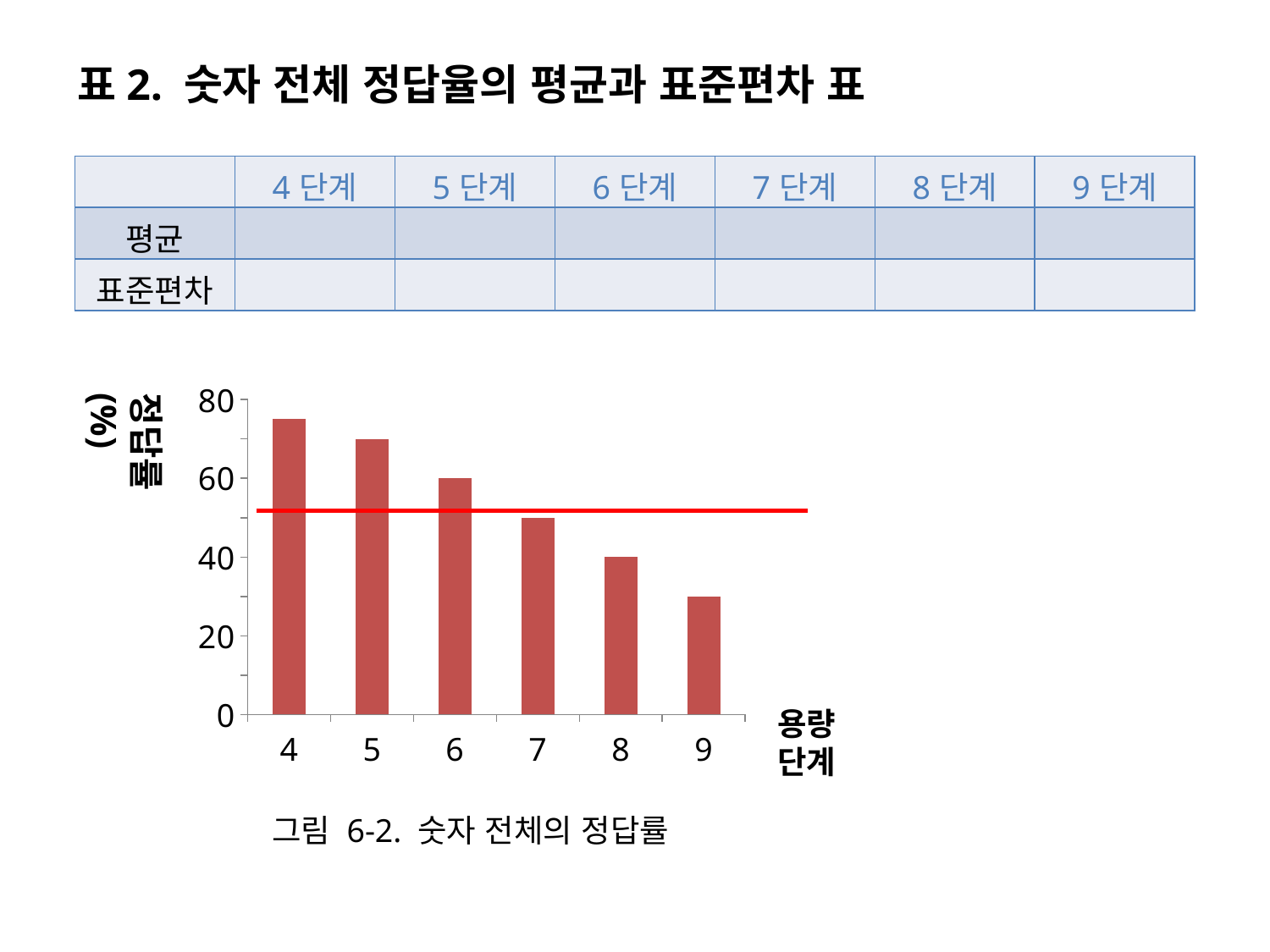
Which has a larger 정답률, 용량 단계 5 or 용량 단계 8? 5 Is the 정답률 for 용량 단계 7 greater or less than 60? less Which 용량 단계 has the highest 정답률 in the chart? 4 How many categories (용량 단계) are plotted on the x axis of the chart? 6 Is the 정답률 for 용량 단계 4 greater or less than 60? greater Which 용량 단계 has the lowest 정답률 in the chart? 9 Is the 정답률 for 용량 단계 9 greater or less than 40? less What is the caption of the chart shown below the table? 그림 6-2. 숫자 전체의 정답률 Do the 정답률 values rise or fall as 용량 단계 increases from 4 to 9? fall What kind of chart is shown on the slide? bar chart What is the label of the y axis of the chart? 정답률 (%)